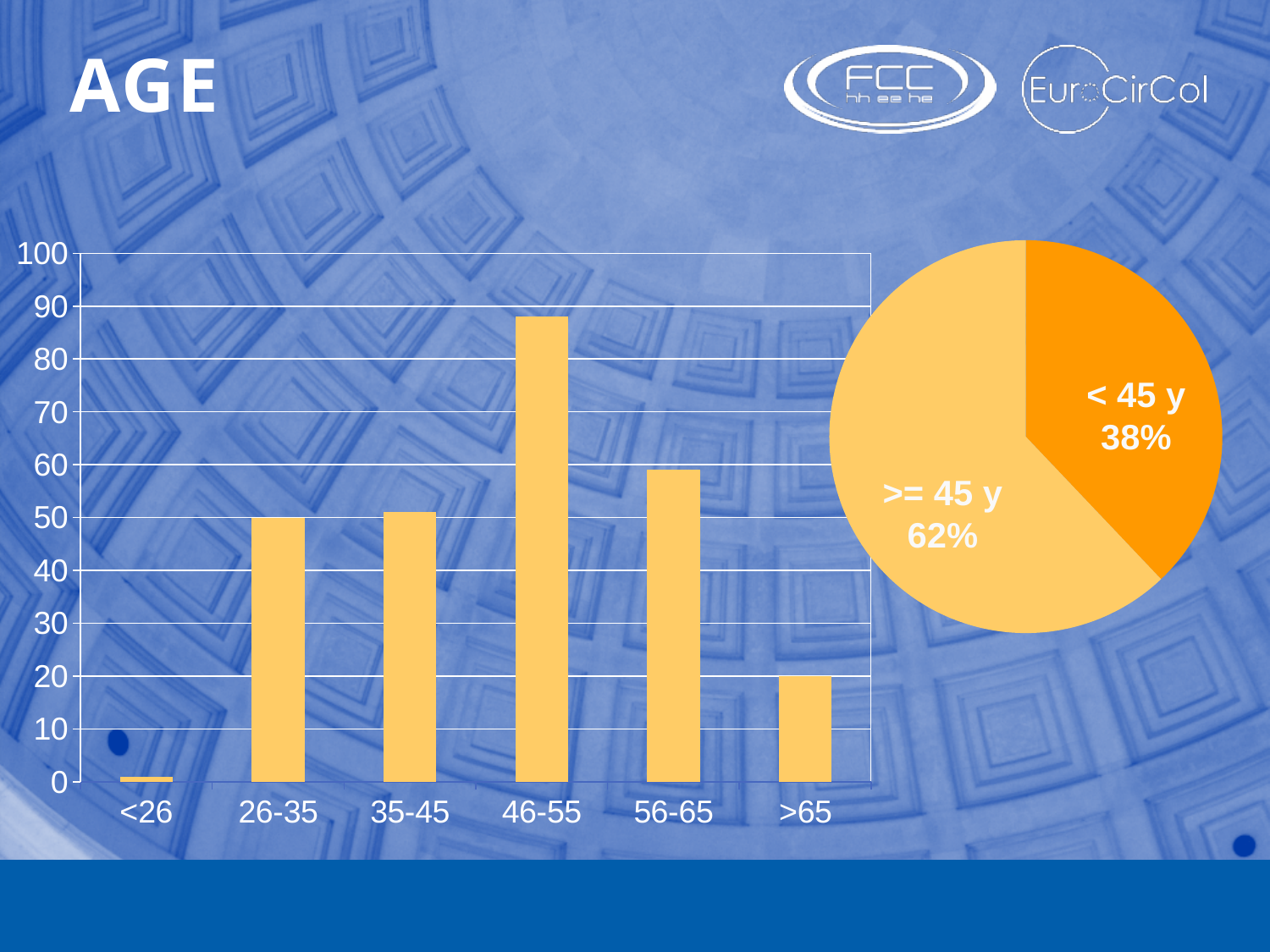
In the bar chart on the left, how many age categories are shown on the x axis? 6 In the pie chart on the right, what share is labelled for the >= 45 y slice? 62% In the bar chart on the left, what is the value for the 26-35 category? 50 What kind of chart is the chart on the left of the slide? bar chart In the bar chart on the left, is the value for 56-65 greater or less than 70? less In the bar chart on the left, which age category has the lowest bar? <26 In the bar chart on the left, is the value for 46-55 greater or less than 80? greater In the bar chart on the left, which age category has the highest bar? 46-55 In the pie chart on the right, what share is labelled for the < 45 y slice? 38% In the bar chart on the left, which is larger, the value for 46-55 or the value for 56-65? 46-55 What kind of chart is the chart on the right of the slide? pie chart In the bar chart on the left, what is the value for the >65 category? 20